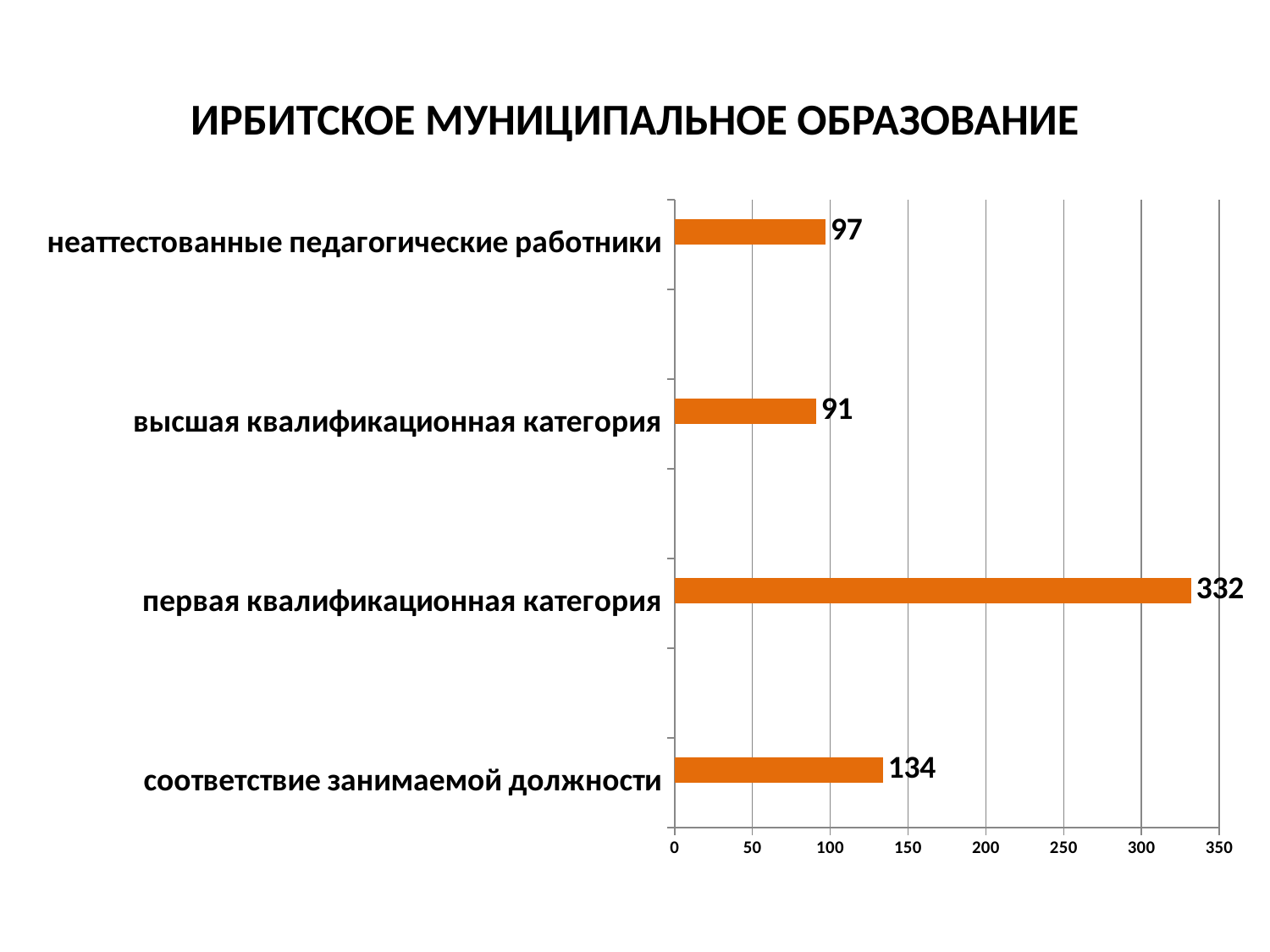
Which is larger: the value for «соответствие занимаемой должности» or for «неаттестованные педагогические работники»? соответствие занимаемой должности What is the value for «высшая квалификационная категория»? 91 What is the value for «неаттестованные педагогические работники»? 97 Which category has the highest value? первая квалификационная категория What kind of chart is shown on the slide? bar chart What is the difference between the values for «первая квалификационная категория» and «соответствие занимаемой должности»? 198 How many categories are shown in the chart? 4 What is the title of the slide? ИРБИТСКОЕ МУНИЦИПАЛЬНОЕ ОБРАЗОВАНИЕ What is the value for «первая квалификационная категория»? 332 What is the difference between the values for «неаттестованные педагогические работники» and «высшая квалификационная категория»? 6 What is the value for «соответствие занимаемой должности»? 134 Which category has the lowest value? высшая квалификационная категория